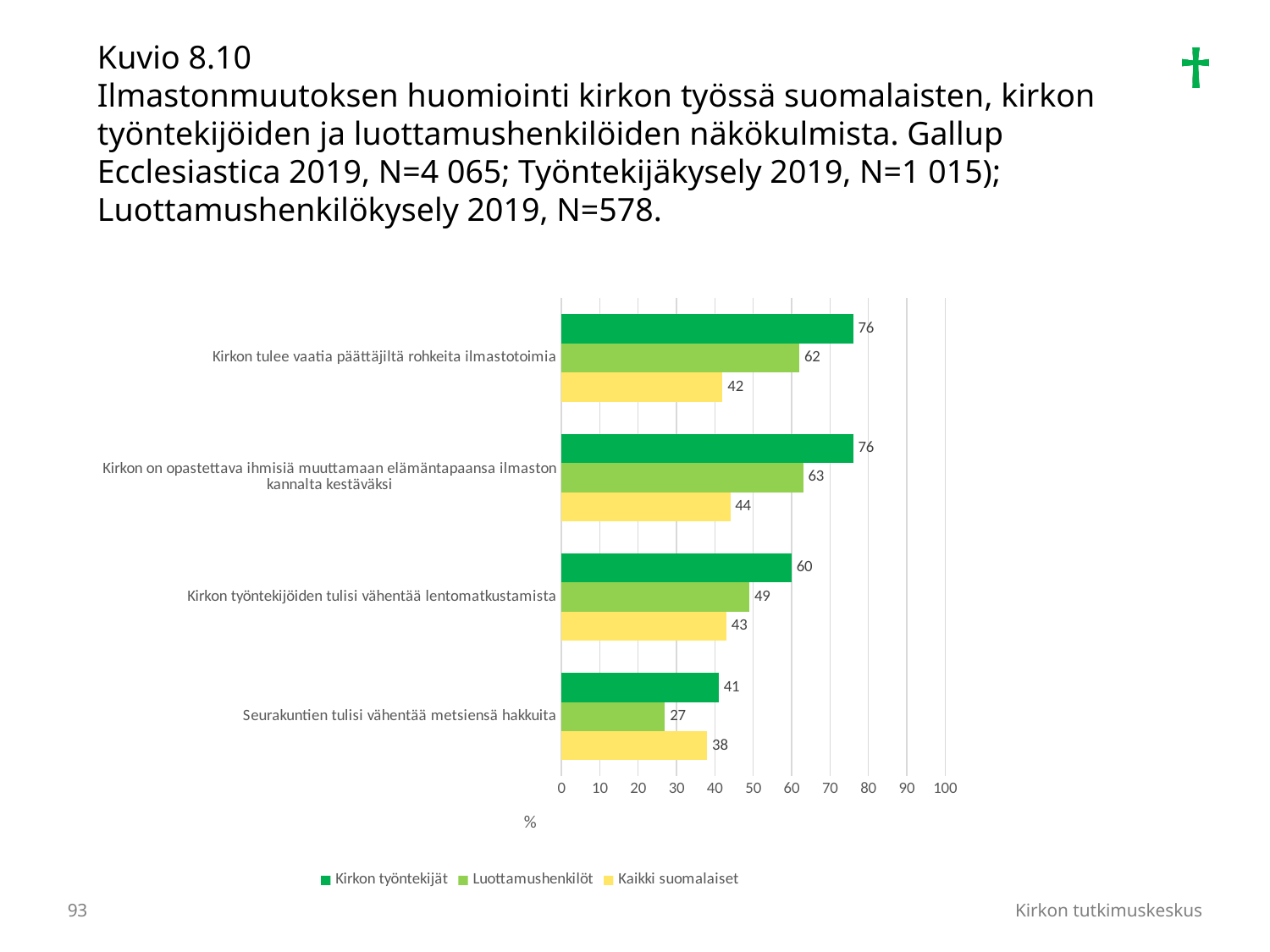
For "Seurakuntien tulisi vähentää metsiensä hakkuita", which is larger: the Luottamushenkilöt value or the Kaikki suomalaiset value? Kaikki suomalaiset What unit is shown on the horizontal axis of the chart? % What is the value for Kaikki suomalaiset for "Seurakuntien tulisi vähentää metsiensä hakkuita"? 38 What is the value for Kirkon työntekijät for "Kirkon tulee vaatia päättäjiltä rohkeita ilmastotoimia"? 76 What is the value for Luottamushenkilöt for "Kirkon työntekijöiden tulisi vähentää lentomatkustamista"? 49 How many categories are shown on the chart? 4 Which category has the lowest value for Luottamushenkilöt? Seurakuntien tulisi vähentää metsiensä hakkuita Is the Kirkon työntekijät value for "Kirkon työntekijöiden tulisi vähentää lentomatkustamista" greater or less than 50? greater Which category has the highest value for Kaikki suomalaiset? Kirkon on opastettava ihmisiä muuttamaan elämäntapaansa ilmaston kannalta kestäväksi How many series does the legend list? 3 What is the difference between the Kirkon työntekijät and Kaikki suomalaiset values for "Kirkon tulee vaatia päättäjiltä rohkeita ilmastotoimia"? 34 What kind of chart is shown on the slide? Bar chart